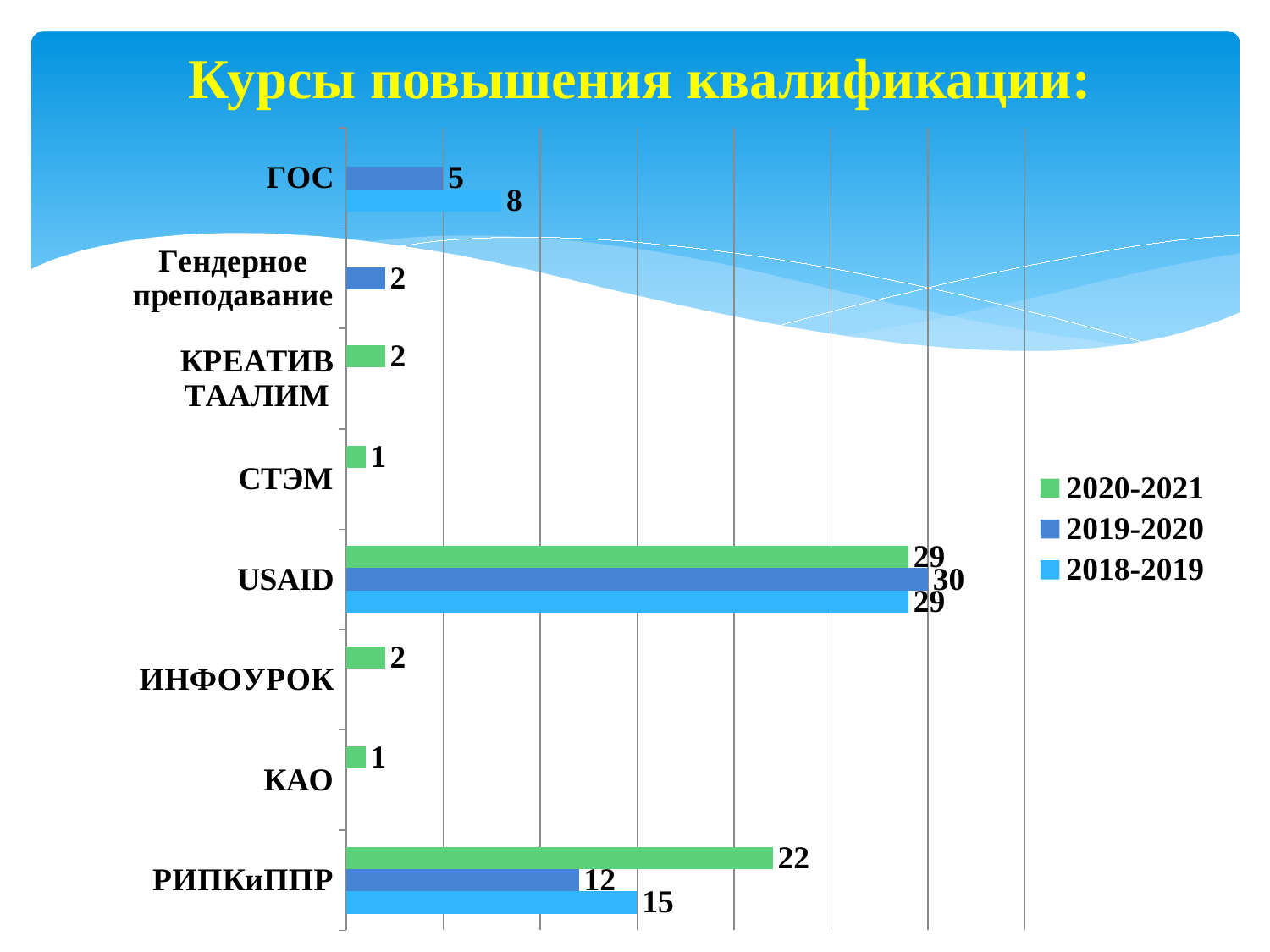
What is the difference between the 2018-2019 and 2019-2020 values for ГОС? 3 What is the value for USAID in the 2019-2020 series? 30 What is the title of the chart? Курсы повышения квалификации: What type of chart is shown on the slide? bar chart Which category has the highest value in the 2020-2021 series? USAID What is the difference between the 2020-2021 and 2019-2020 values for РИПКиППР? 10 What is the value for Гендерное преподавание in the 2019-2020 series? 2 How many series does the legend list? 3 What is the value for ГОС in the 2018-2019 series? 8 What is the value for РИПКиППР in the 2020-2021 series? 22 How many categories are shown on the chart? 8 Which is larger for ГОС: the 2019-2020 value or the 2018-2019 value? 2018-2019